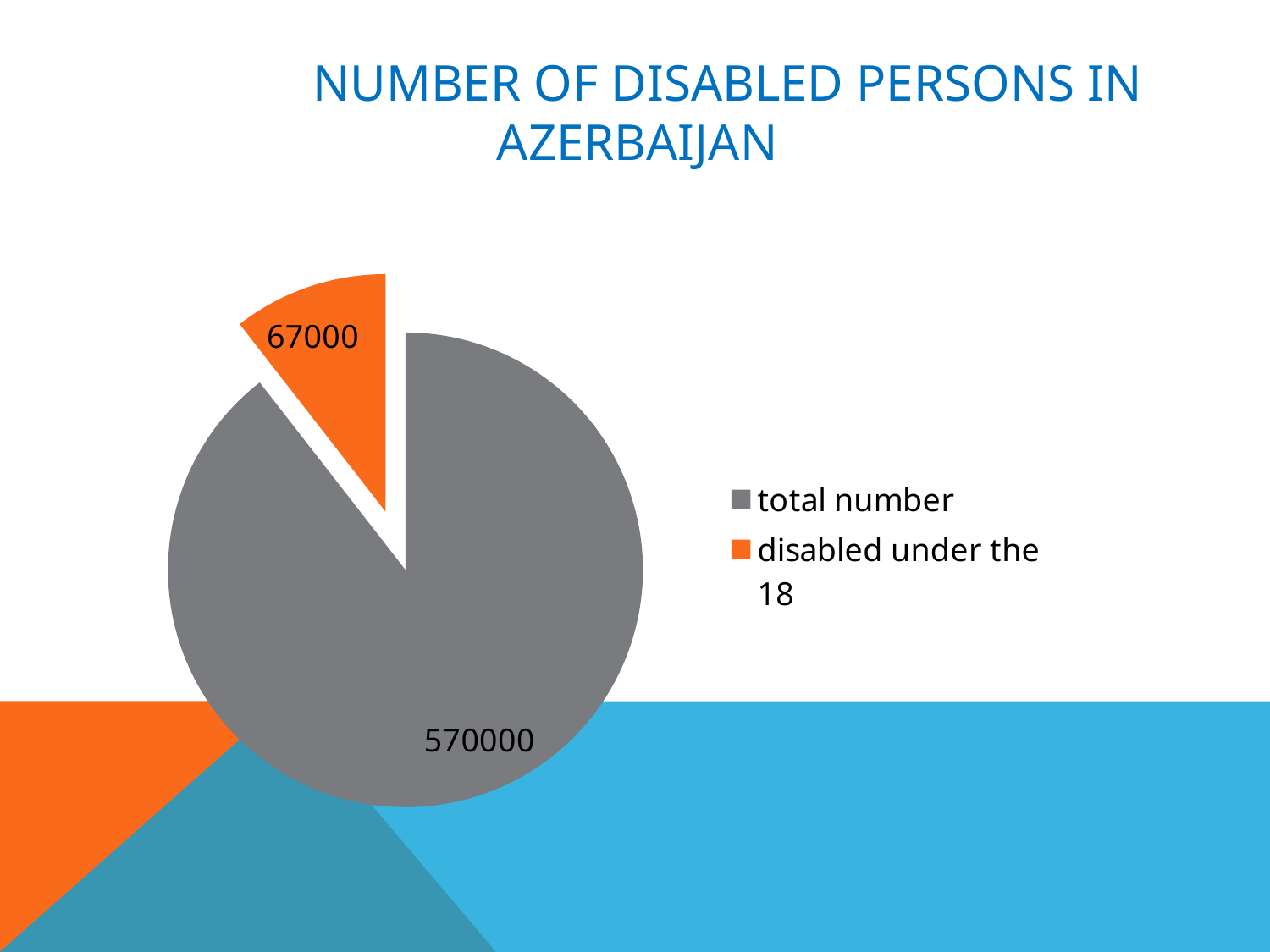
Which slice is the largest? total number How many slices does the pie chart have? 2 How many entries does the legend list? 2 Which slice is the smallest? disabled under the 18 What is the difference between the 'total number' value and the 'disabled under the 18' value? 503000 Which is larger, the 'total number' slice or the 'disabled under the 18' slice? total number What colour is the 'disabled under the 18' slice? orange What kind of chart is shown on the slide? pie chart What value is shown for the 'disabled under the 18' slice? 67000 What is the title of the slide? NUMBER OF DISABLED PERSONS IN AZERBAIJAN What value is shown for the 'total number' slice? 570000